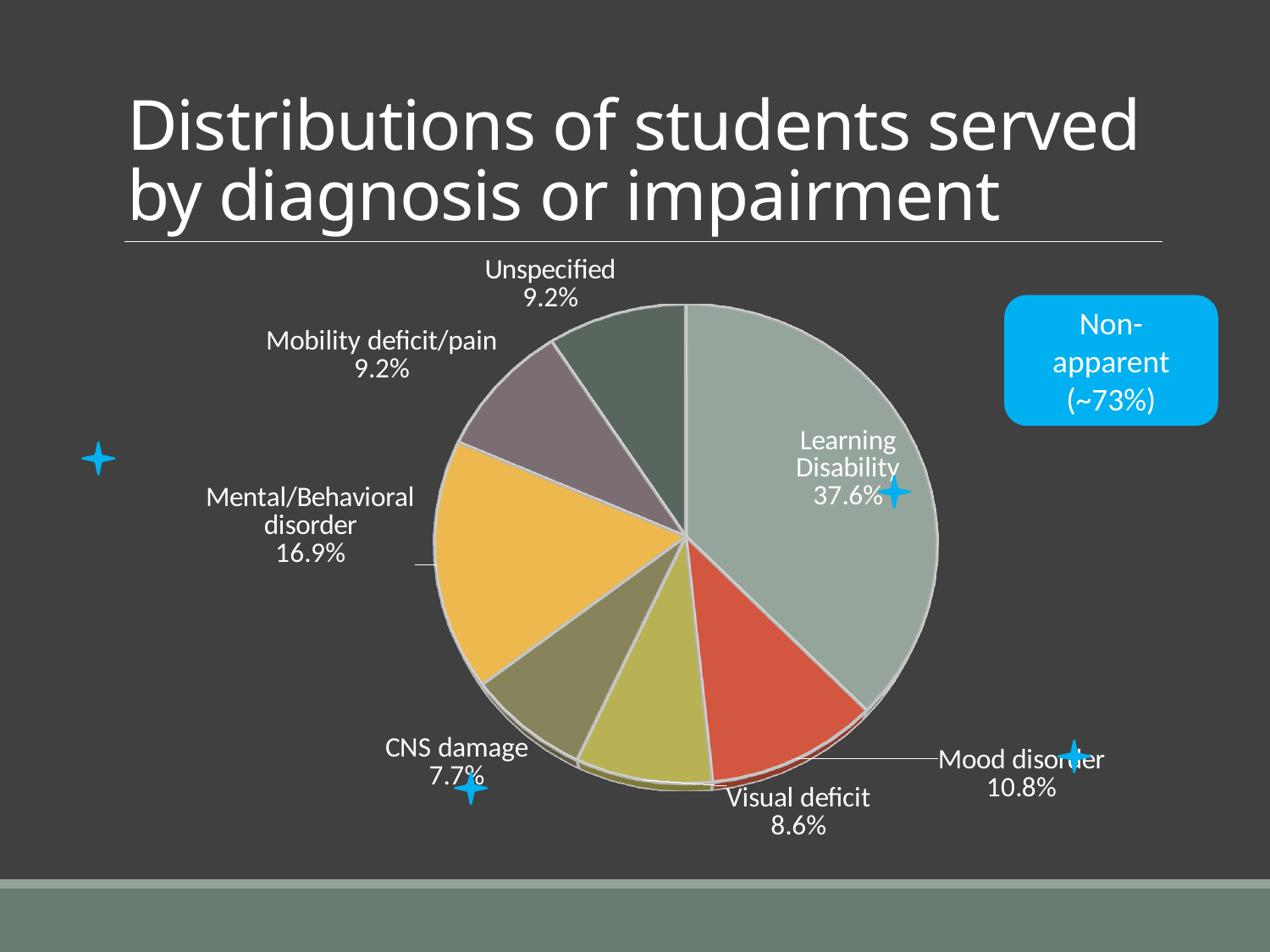
What percentage of students served have a Mental/Behavioral disorder? 16.9% What kind of chart is shown on the slide? pie chart Which diagnosis or impairment category has the largest share of students served? Learning Disability What is the difference in percentage points between Learning Disability and Mental/Behavioral disorder? 20.7 What percentage of students served have a Learning Disability? 37.6% What is the title of the chart on the slide? Distributions of students served by diagnosis or impairment What percentage of students served have a Mood disorder? 10.8% Which diagnosis or impairment category has the smallest share of students served? CNS damage Which has a larger share of students served, Mood disorder or Visual deficit? Mood disorder How many diagnosis or impairment categories are shown in the pie chart? 7 What percentage of students served have CNS damage? 7.7% What percentage of students served have a Visual deficit? 8.6%